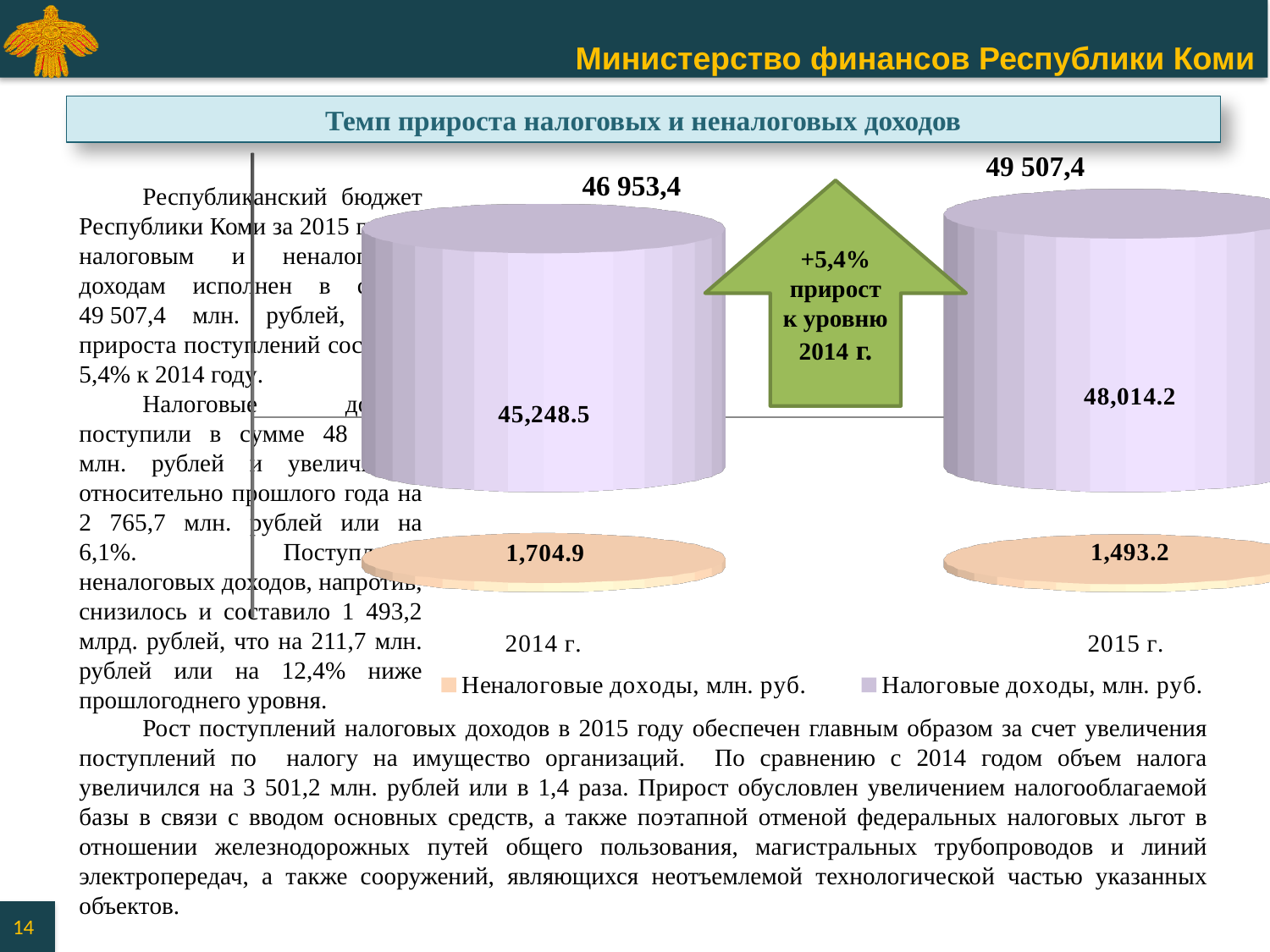
What is the value of Налоговые доходы, млн. руб. for 2014 г.? 45,248.5 What is the value of Неналоговые доходы, млн. руб. for 2015 г.? 1,493.2 Which year has the lower value for Неналоговые доходы, млн. руб.? 2015 г. What is the value of Неналоговые доходы, млн. руб. for 2014 г.? 1,704.9 What is the total shown above the stacked bar for 2014 г.? 46 953,4 Which year has the higher value for Налоговые доходы, млн. руб.? 2015 г. What is the total shown above the stacked bar for 2015 г.? 49 507,4 What kind of chart is shown on the slide? Stacked bar chart What is the title of the chart? Темп прироста налоговых и неналоговых доходов What is the value of Налоговые доходы, млн. руб. for 2015 г.? 48,014.2 How many categories are shown on the x axis? 2 How many series does the legend list? 2